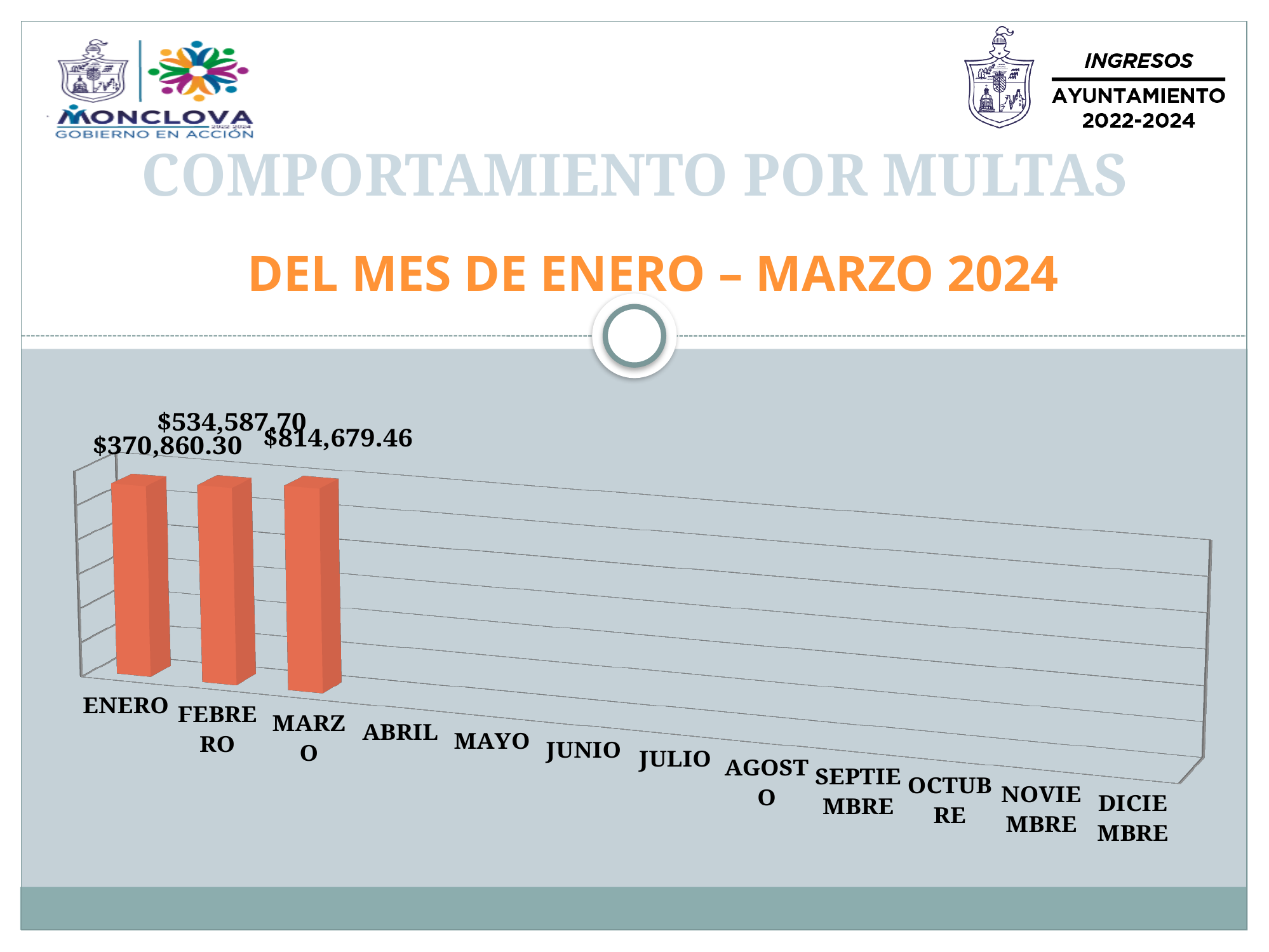
How many month categories are listed on the x axis? 12 Which is larger, the value for FEBRERO or the value for MARZO? MARZO What is the difference between the values for MARZO and ENERO? $443,819.16 What kind of chart is shown on the slide? Bar chart What is the value for FEBRERO? $534,587.70 What is the difference between the values for FEBRERO and ENERO? $163,727.40 Do the labelled values rise or fall from ENERO to MARZO? Rise What is the value for MARZO? $814,679.46 Which month has the highest value shown? MARZO How many months have a bar with a data label plotted? 3 Which month has the lowest value shown? ENERO What is the value for ENERO? $370,860.30